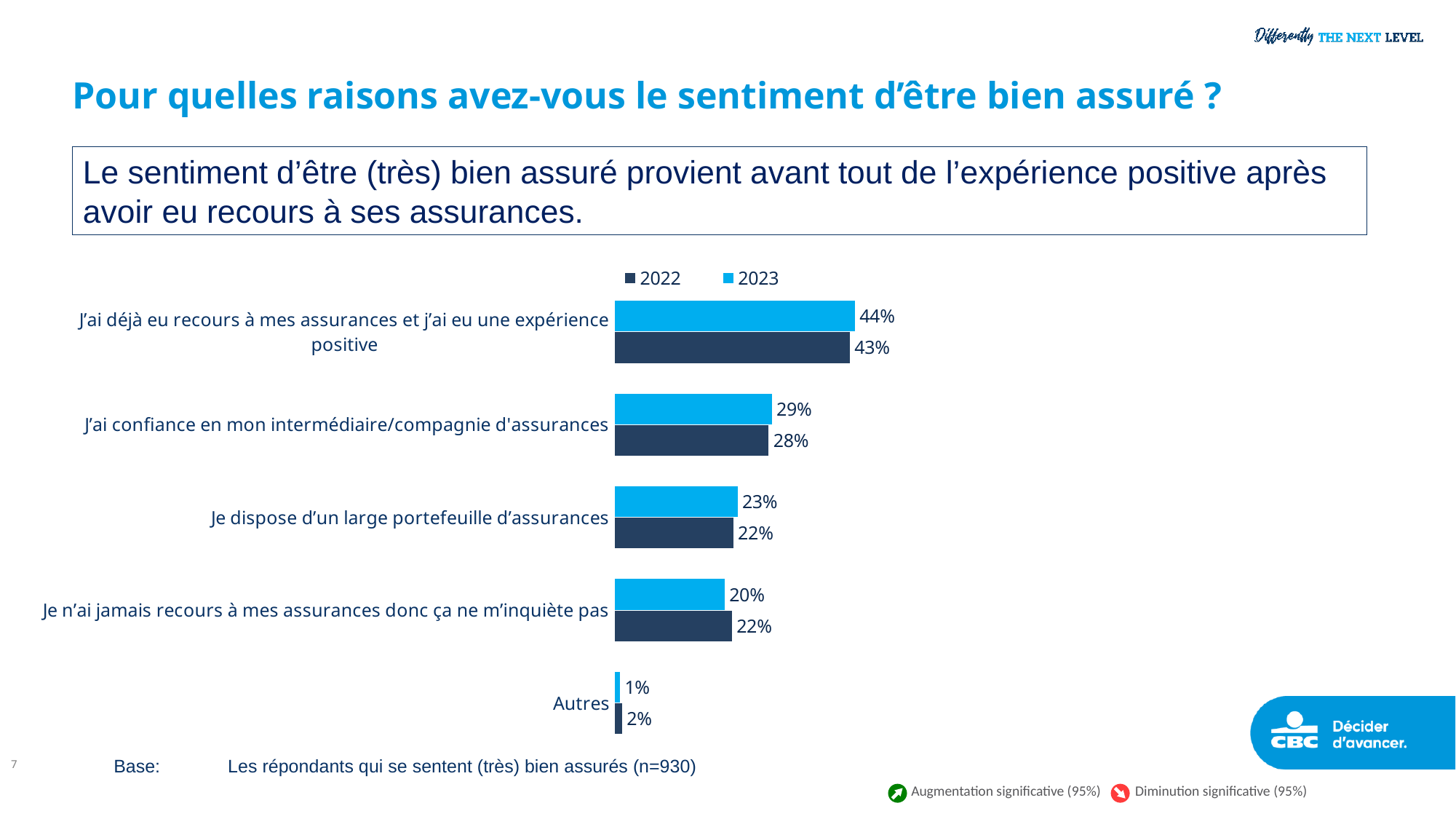
How many series does the legend list? 2 Which series is shown in dark blue in the legend? 2022 Which category has the highest 2023 value? J'ai déjà eu recours à mes assurances et j'ai eu une expérience positive What is the difference between the 2023 and 2022 values for "Je dispose d'un large portefeuille d'assurances"? 1% What is the 2023 value for "J'ai déjà eu recours à mes assurances et j'ai eu une expérience positive"? 44% What is the 2022 value for "J'ai confiance en mon intermédiaire/compagnie d'assurances"? 28% What is the 2023 value for "Autres"? 1% For "Je n'ai jamais recours à mes assurances donc ça ne m'inquiète pas", which year has the larger value, 2022 or 2023? 2022 What kind of chart is shown on the slide? Bar chart Which category has the lowest 2022 value? Autres What is the 2022 value for "Je n'ai jamais recours à mes assurances donc ça ne m'inquiète pas"? 22% How many categories are shown in the chart? 5